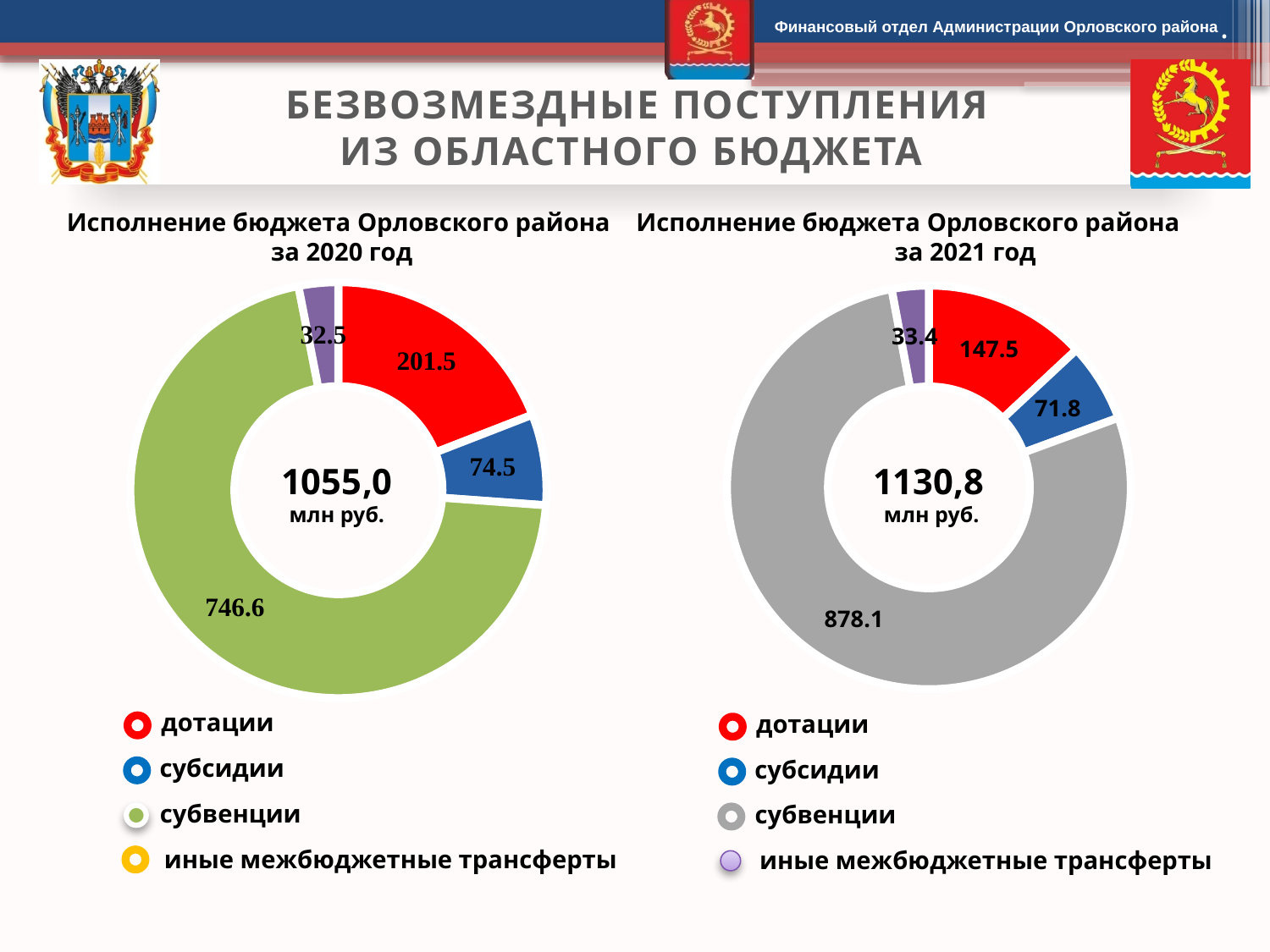
In the 2021 chart, what is the value for иные межбюджетные трансферты? 33.4 In the 2020 chart, what is the value for субсидии? 74.5 In the 2021 chart, what is the difference between дотации and субсидии? 75.7 In the 2021 chart, which category has the smallest slice? иные межбюджетные трансферты In the 2020 chart, what is the difference between дотации and субсидии? 127.0 In the 2020 chart (Исполнение бюджета Орловского района за 2020 год), what is the value for дотации? 201.5 What total is shown in the centre of the 2021 chart? 1130,8 млн руб. In the 2021 chart (Исполнение бюджета Орловского района за 2021 год), what is the value for субвенции? 878.1 What type of chart is used on this slide? Doughnut (pie) chart In the 2020 chart, which category has the largest slice? субвенции Which is larger: субвенции in the 2020 chart or субвенции in the 2021 chart? 2021 (878.1) How many categories does the legend of the 2020 chart list? 4